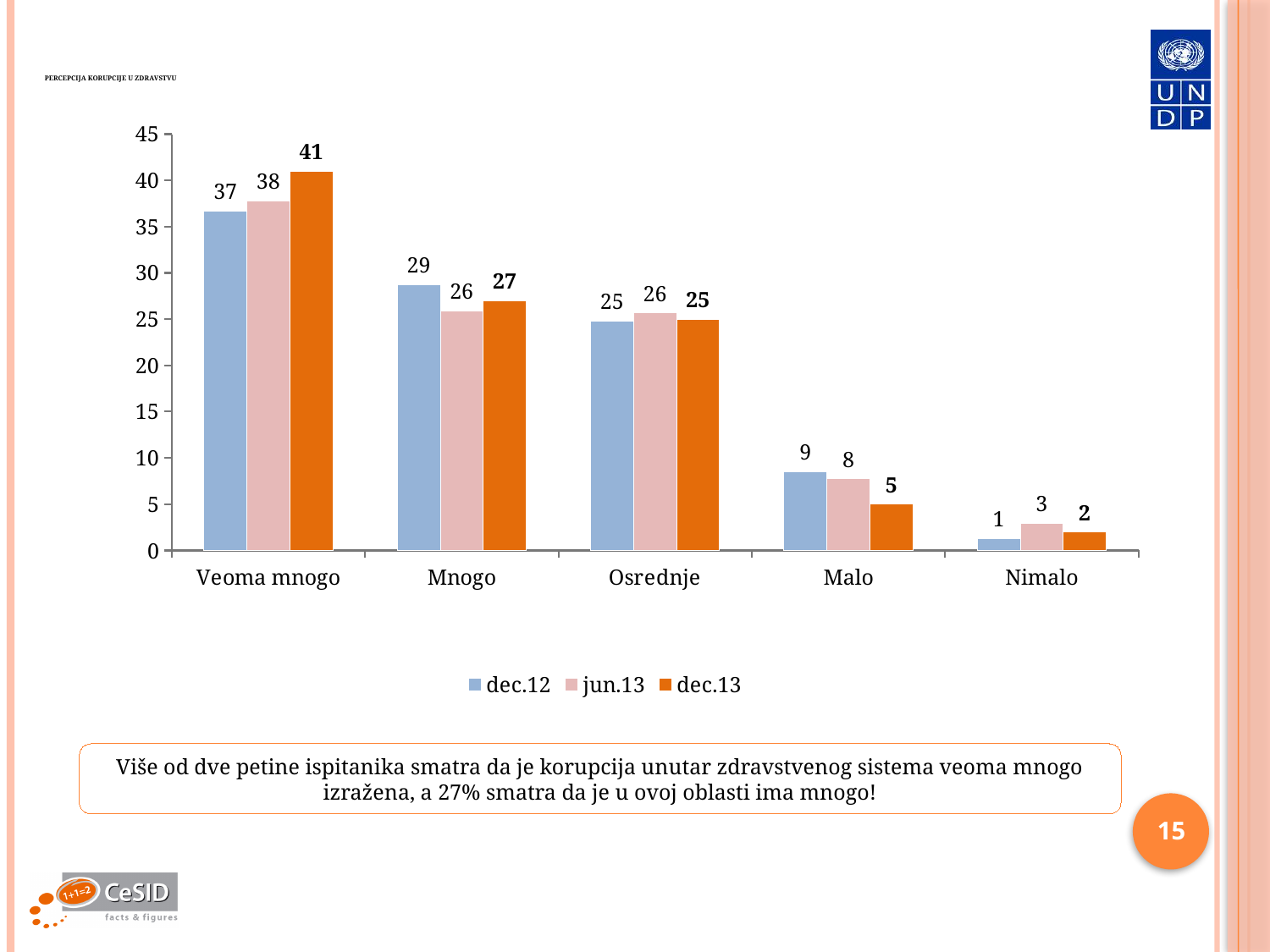
What is the value for Veoma mnogo in the dec.13 series? 41 What kind of chart is shown on the slide? bar chart Which series is shown in orange in the legend? dec.13 What is the value for Mnogo in the dec.12 series? 29 Is the jun.13 value for Veoma mnogo greater or less than 35? greater How many categories are shown on the x axis? 5 How many series does the legend list? 3 Which category has the highest value in the dec.13 series? Veoma mnogo What is the value for Malo in the jun.13 series? 8 What is the difference between the dec.13 and dec.12 values for Veoma mnogo? 4 Which is larger for Malo: the dec.12 value or the dec.13 value? dec.12 Which category has the lowest value in the dec.12 series? Nimalo